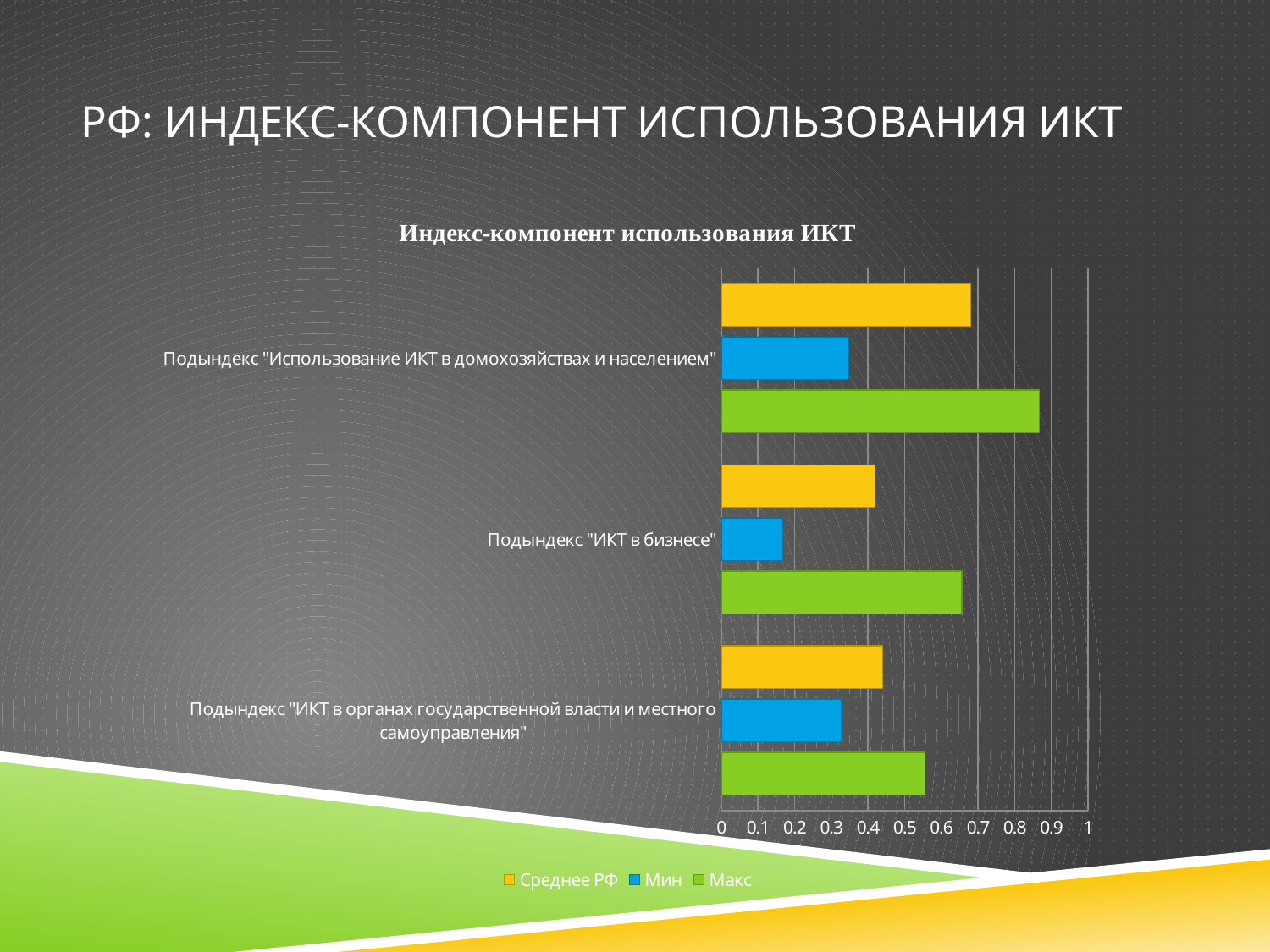
What is the title of the chart? Индекс-компонент использования ИКТ How many series does the legend list? 3 Which series is shown in green in the legend? Макс How many categories (sub-indices) are shown on the chart? 3 Is the Мин value for Подындекс "ИКТ в бизнесе" greater or less than 0.2? less Which is larger: the Среднее РФ value for Подындекс "Использование ИКТ в домохозяйствах и населением" or the Среднее РФ value for Подындекс "ИКТ в бизнесе"? Подындекс "Использование ИКТ в домохозяйствах и населением" Is the Макс value for Подындекс "Использование ИКТ в домохозяйствах и населением" greater or less than 0.8? greater Is the Среднее РФ value for Подындекс "ИКТ в органах государственной власти и местного самоуправления" greater or less than 0.5? less Which category has the highest value for the Макс series? Подындекс "Использование ИКТ в домохозяйствах и населением" Which category has the lowest value for the Мин series? Подындекс "ИКТ в бизнесе" Which category has the lowest value for the Макс series? Подындекс "ИКТ в органах государственной власти и местного самоуправления" What kind of chart is shown on the slide? bar chart